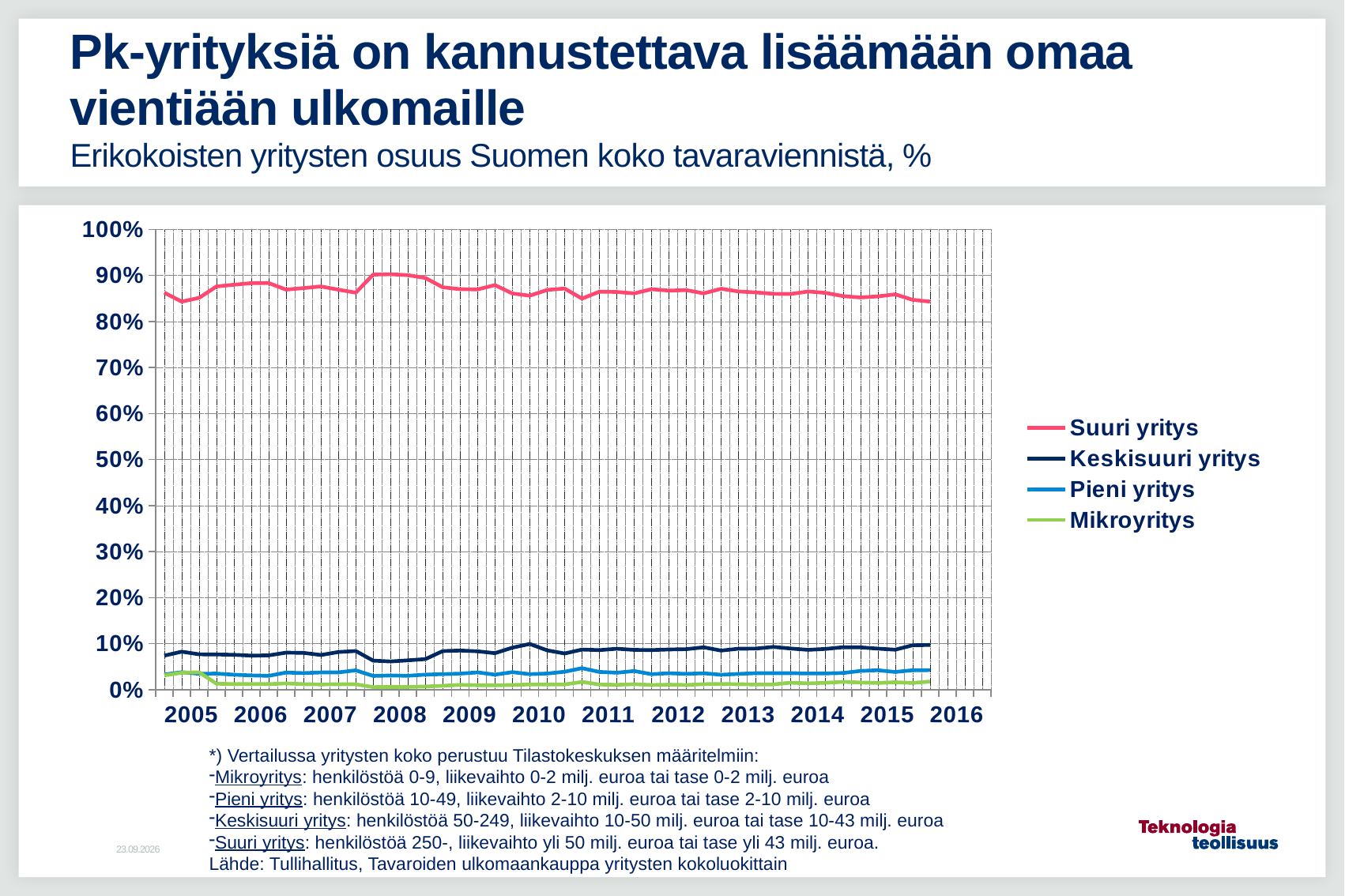
Which series has the lowest values throughout the chart? Mikroyritys Which series has the highest values throughout the chart? Suuri yritys In 2010, which is larger: the value for Keskisuuri yritys or the value for Pieni yritys? Keskisuuri yritys How many series does the legend list? 4 In 2013, which is larger: the value for Suuri yritys or the value for Keskisuuri yritys? Suuri yritys Is the value for Pieni yritys in 2014 greater or less than 10%? less Is the value for Keskisuuri yritys in 2012 greater or less than 20%? less Is the value for Mikroyritys in 2008 greater or less than 10%? less What kind of chart is shown on the slide? Line chart What colour is the line for Mikroyritys? Green How many year labels are shown on the x axis? 12